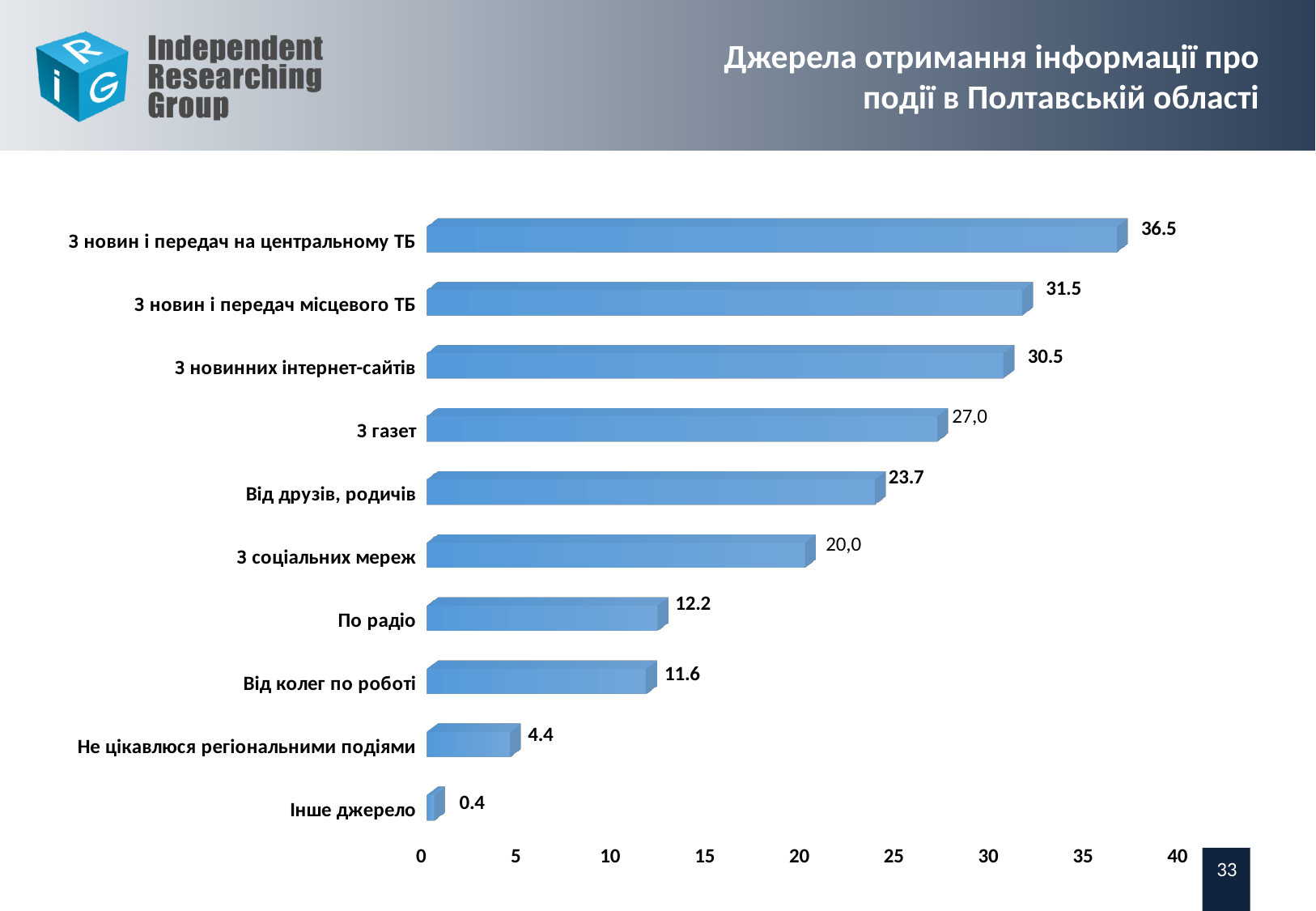
What is the value for "З газет"? 27,0 What is the value for "З новин і передач на центральному ТБ"? 36.5 What is the difference between the values for "З новин і передач на центральному ТБ" and "З новин і передач місцевого ТБ"? 5.0 Which is larger, the value for "По радіо" or the value for "Від колег по роботі"? По радіо What is the title of the slide? Джерела отримання інформації про події в Полтавській області How many categories are shown in the chart? 10 Is the value for "Від друзів, родичів" greater or less than 20? greater What is the value for "Не цікавлюся регіональними подіями"? 4.4 What kind of chart is shown on the slide? bar chart Which category has the lowest value? Інше джерело Which category has the highest value? З новин і передач на центральному ТБ What is the value for "По радіо"? 12.2